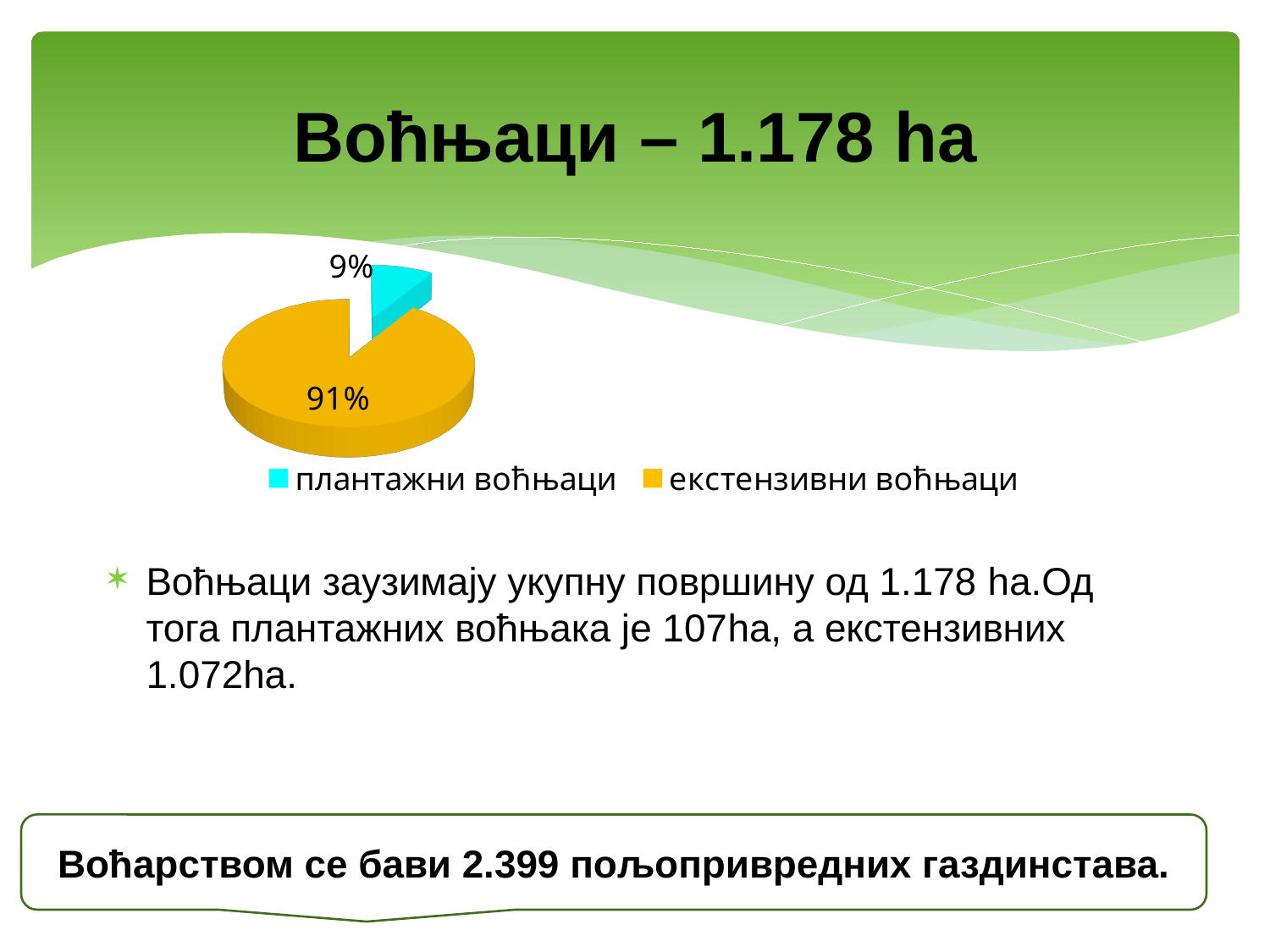
What is the difference in percentage points between the екстензивни воћњаци slice and the плантажни воћњаци slice? 82 How many slices does the pie chart have? 2 What share of the pie does плантажни воћњаци represent? 9% What kind of chart is shown on the slide? pie chart How many entries does the legend list? 2 Which is larger, the share for плантажни воћњаци or the share for екстензивни воћњаци? екстензивни воћњаци Which slice of the pie is the largest? екстензивни воћњаци What share of the pie does екстензивни воћњаци represent? 91% What colour is the slice for екстензивни воћњаци? orange Which slice of the pie is the smallest? плантажни воћњаци What colour is the slice for плантажни воћњаци? cyan